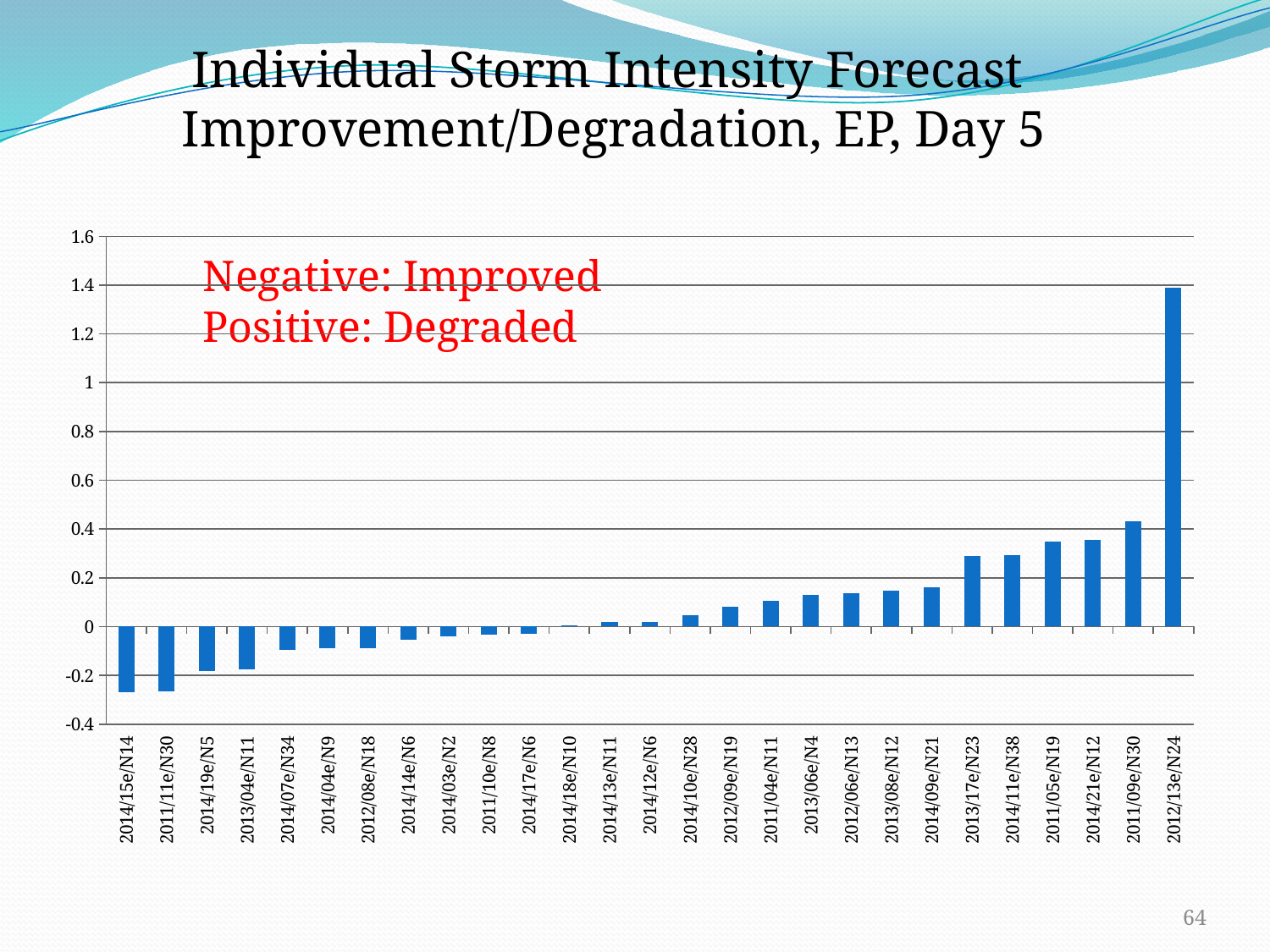
Is the value for 2014/15e/N14 greater or less than -0.2? less Is the value for 2011/09e/N30 greater or less than 0.2? greater Do the bar values generally rise or fall moving from left to right along the x axis? rise Is the value for 2013/17e/N23 greater or less than 0.2? greater According to the red annotation on the chart, what does a negative value indicate? Improved Which storm has the highest value in the chart? 2012/13e/N24 What kind of chart is shown on the slide? bar chart How many storms (categories) are plotted along the x axis? 27 Which has the larger value, 2012/13e/N24 or 2011/09e/N30? 2012/13e/N24 Which has the larger value, 2014/15e/N14 or 2014/18e/N10? 2014/18e/N10